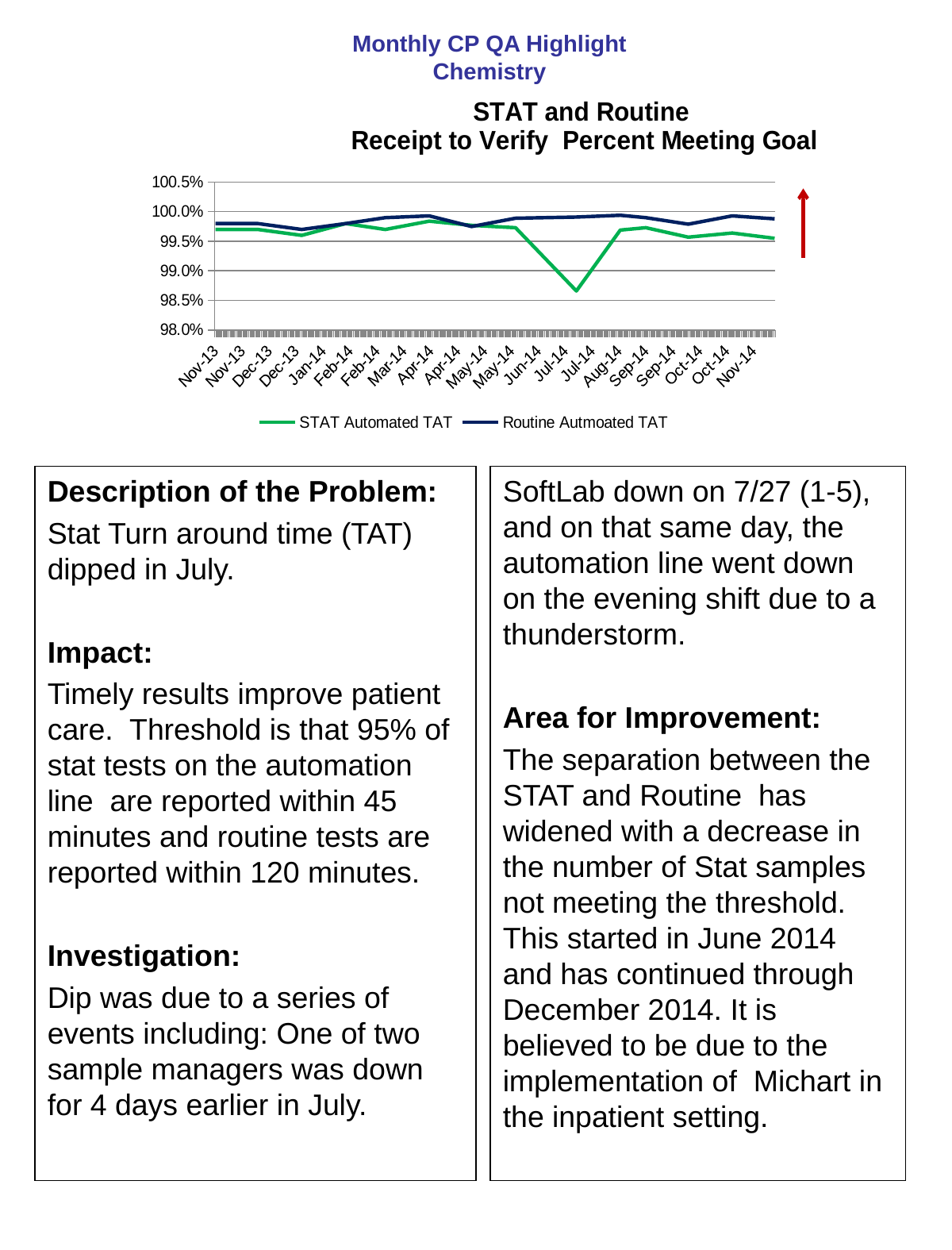
Is the lowest value of the STAT Automated TAT series greater or less than 98.5%? greater Is the lowest value of the STAT Automated TAT series greater or less than 99.0%? less Is the Routine Autmoated TAT value in Jul-14 greater or less than 99.5%? greater In which month does the STAT Automated TAT series reach its lowest value? Jul-14 What is the title of the chart? STAT and Routine Receipt to Verify Percent Meeting Goal What are the two series named in the chart legend? STAT Automated TAT and Routine Autmoated TAT Does the STAT Automated TAT series rise or fall between Jul-14 and Aug-14? rise Which series stays above 99.5% for the entire period shown? Routine Autmoated TAT In Jul-14, which series has the higher value, STAT Automated TAT or Routine Autmoated TAT? Routine Autmoated TAT Does the STAT Automated TAT series rise or fall between Jun-14 and Jul-14? fall What kind of chart is shown on the slide? Line chart How many series does the chart legend list? 2